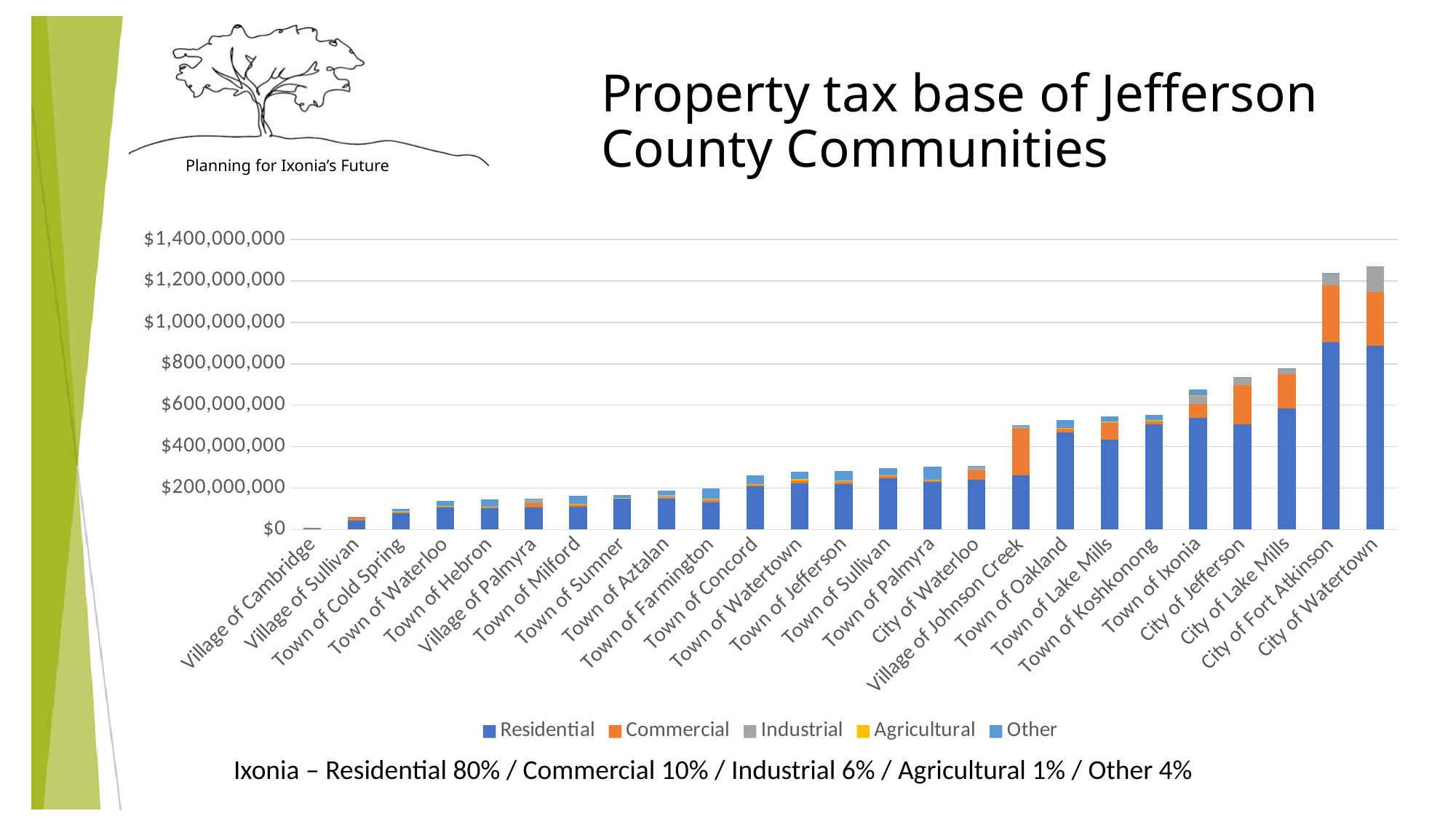
How many communities are shown along the x axis? 25 Do the total bar heights generally rise or fall from left to right along the x axis? Rise Is the total value for Town of Ixonia greater or less than $600,000,000? greater Which has the larger total property tax base, Village of Johnson Creek or Town of Concord? Village of Johnson Creek Which series is shown in orange in the legend? Commercial Is the total value for Town of Concord greater or less than $200,000,000? greater Which community has the lowest total property tax base? Village of Cambridge Is the total value for Town of Oakland greater or less than $400,000,000? greater What kind of chart is shown on the slide? Stacked bar chart Which has the larger total property tax base, City of Jefferson or Town of Ixonia? City of Jefferson How many series does the legend list? 5